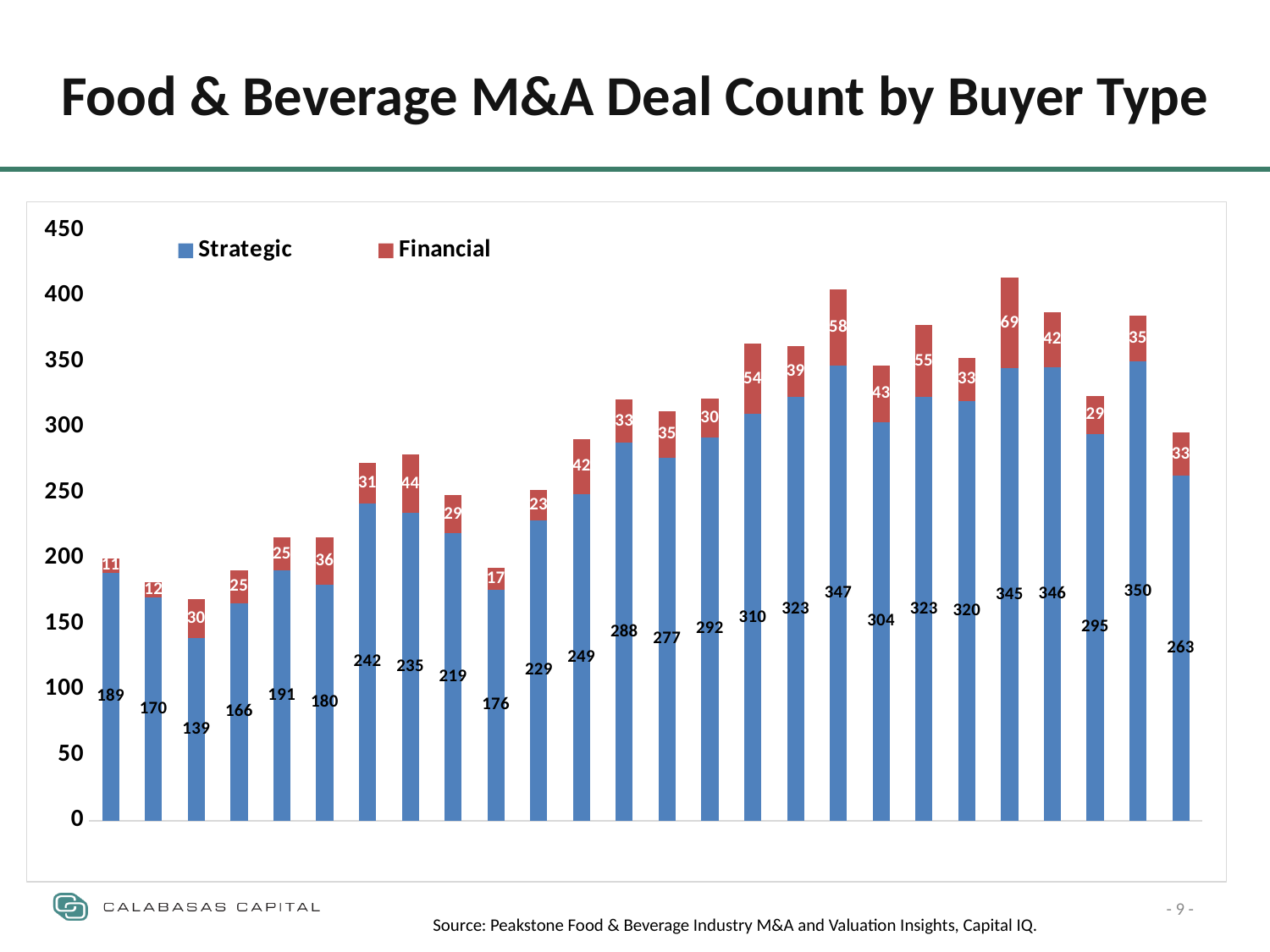
How many series does the legend list? 2 What is the lowest Strategic value shown in the chart? 139 Which series is shown in red in the legend? Financial What is the Financial value for the rightmost bar? 33 What is the total deal count (Strategic plus Financial) for the rightmost bar? 296 What is the highest Strategic value shown in the chart? 350 Which is larger, the Strategic value of the leftmost bar or the Strategic value of the rightmost bar? the rightmost bar How many bars are plotted in the chart? 26 What type of chart is shown on the slide? bar chart What is the Strategic value for the leftmost bar? 189 What is the difference between the highest and lowest Strategic values? 211 What is the highest Financial value shown in the chart? 69